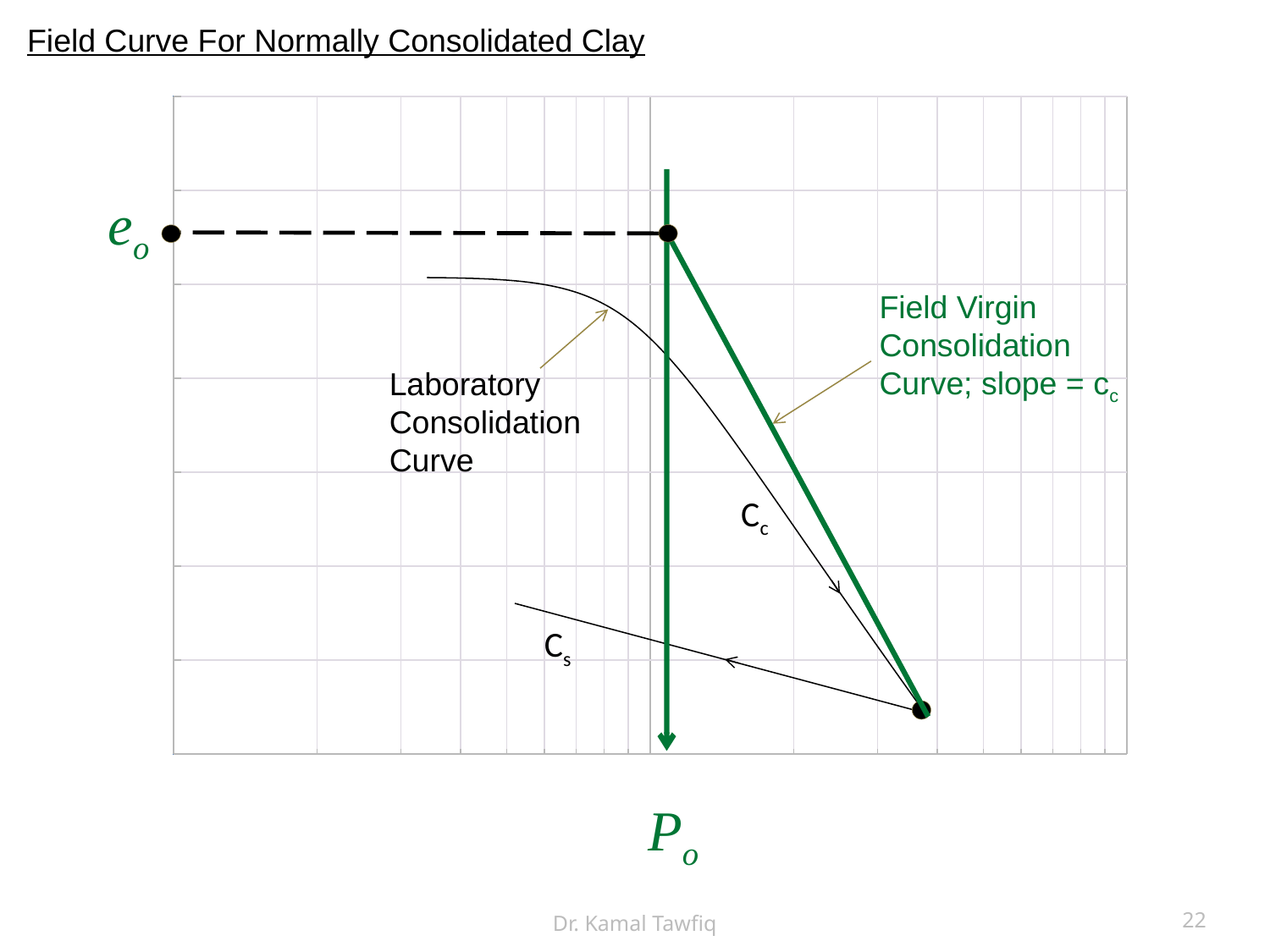
What label is written below the vertical green arrow on the x axis? P_o Does the Field Virgin Consolidation Curve rise or fall as it moves to the right along the x axis? fall Does the Laboratory Consolidation Curve rise or fall as it moves to the right along the x axis? fall What is the title of the slide's chart? Field Curve For Normally Consolidated Clay What colour is the Field Virgin Consolidation Curve drawn in? green What label is placed next to the thin line with the arrow pointing down-right in the middle of the chart? C_c What label is written at the left end of the horizontal dashed line? e_o What label is placed next to the thin line with the arrow pointing left in the lower part of the chart? C_s What kind of chart is shown on the slide? line chart What is the slope of the Field Virgin Consolidation Curve labelled as? c_c